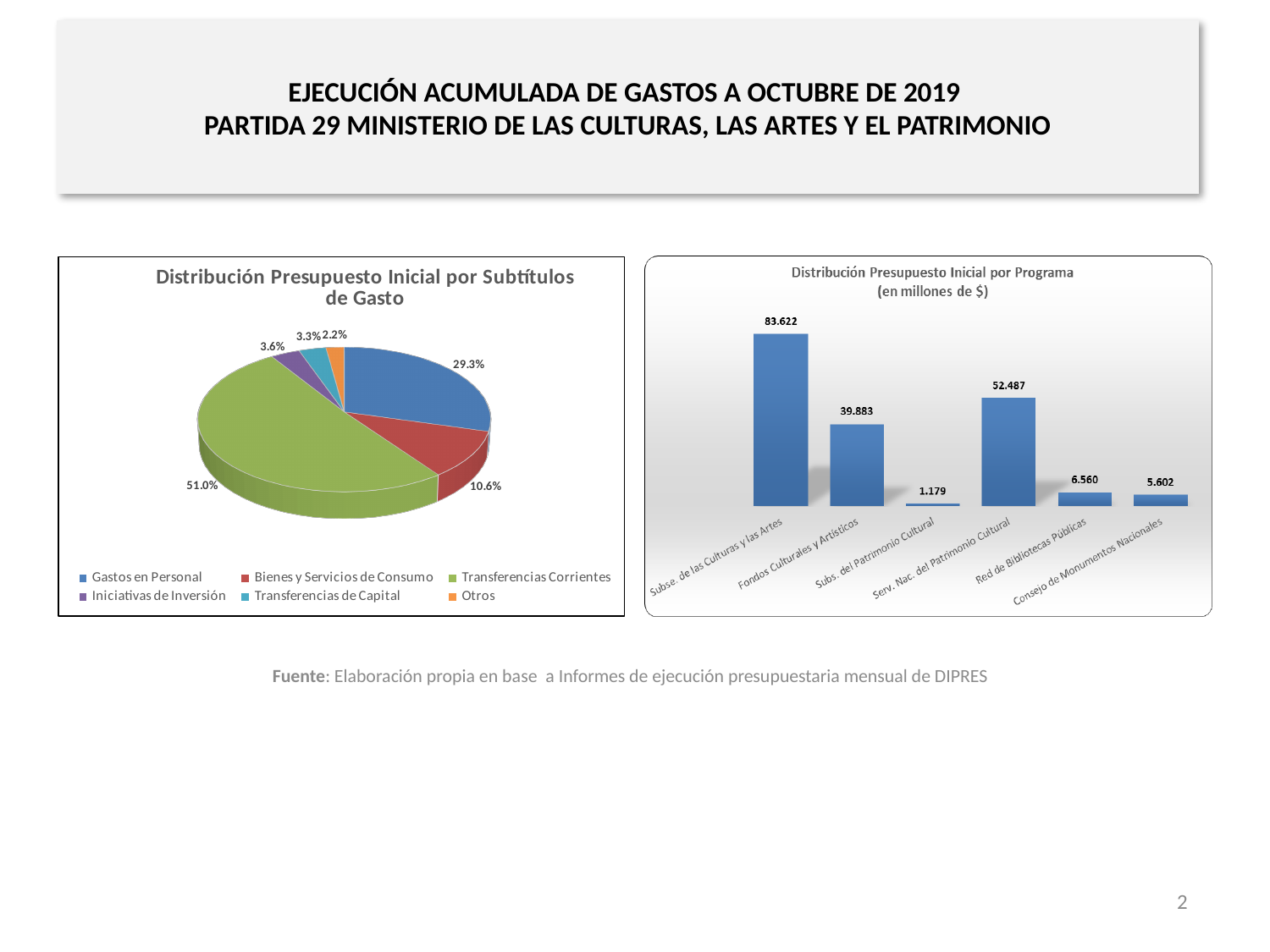
In the 'Distribución Presupuesto Inicial por Programa' chart, which is larger: Fondos Culturales y Artísticos or Serv. Nac. del Patrimonio Cultural? Serv. Nac. del Patrimonio Cultural In the 'Distribución Presupuesto Inicial por Programa' chart, which program has the highest value? Subse. de las Culturas y las Artes In the 'Distribución Presupuesto Inicial por Programa' chart, what is the value for Subse. de las Culturas y las Artes? 83.622 In the 'Distribución Presupuesto Inicial por Programa' chart, what is the value for Serv. Nac. del Patrimonio Cultural? 52.487 What kind of chart is 'Distribución Presupuesto Inicial por Subtítulos de Gasto'? Pie chart In the 'Distribución Presupuesto Inicial por Programa' chart, which program has the lowest value? Subs. del Patrimonio Cultural What kind of chart is 'Distribución Presupuesto Inicial por Programa'? Bar chart In the 'Distribución Presupuesto Inicial por Subtítulos de Gasto' chart, how many categories does the legend list? 6 In the 'Distribución Presupuesto Inicial por Subtítulos de Gasto' chart, what share does Gastos en Personal have? 29.3% In the 'Distribución Presupuesto Inicial por Subtítulos de Gasto' chart, what share does Transferencias Corrientes have? 51.0% In the 'Distribución Presupuesto Inicial por Programa' chart, what is the difference between Red de Bibliotecas Públicas and Consejo de Monumentos Nacionales? 0.958 In the 'Distribución Presupuesto Inicial por Subtítulos de Gasto' chart, which category has the smallest share? Otros